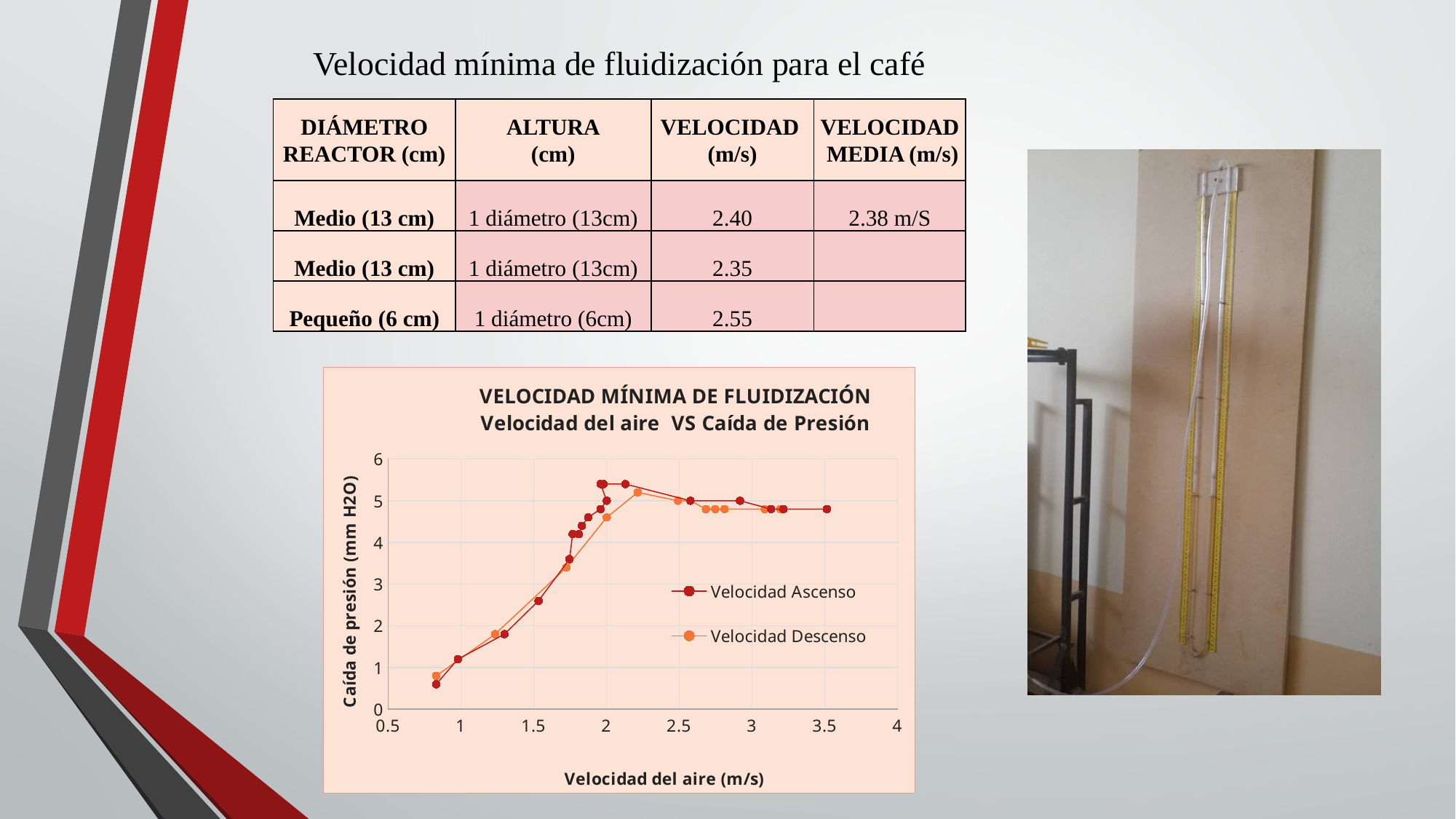
Between air velocities of 1 m/s and 2 m/s, does the Velocidad Ascenso series rise or fall? rise What is the label of the chart's vertical axis? Caída de presión (mm H2O) At an air velocity of about 2 m/s, which series has the higher pressure drop, Velocidad Ascenso or Velocidad Descenso? Velocidad Ascenso Between air velocities of 2.5 m/s and 3.5 m/s, does the Velocidad Ascenso series rise or fall? fall Is the value of Velocidad Ascenso at an air velocity of about 3.5 m/s greater or less than 5? less Is the value of Velocidad Descenso at an air velocity of about 0.8 m/s greater or less than 1? less Is the value of Velocidad Ascenso at an air velocity of about 1.5 m/s greater or less than 2? greater How many series does the chart legend list? 2 What are the two series named in the chart legend? Velocidad Ascenso and Velocidad Descenso What kind of chart is shown on the slide? line chart